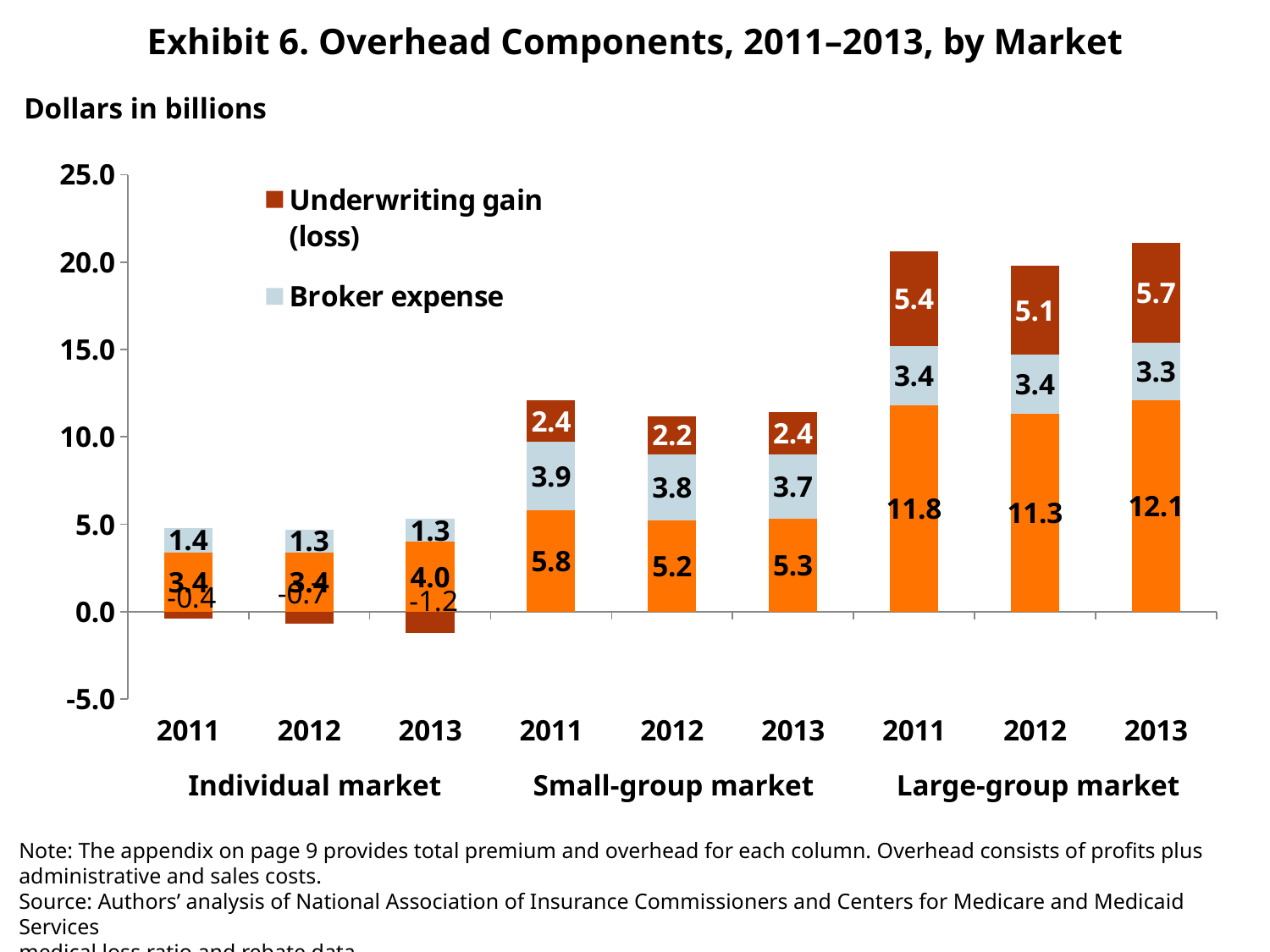
What kind of chart is shown on the slide? Stacked bar chart What is the Underwriting gain (loss) value for the Individual market in 2013? -1.2 What is the total of the stacked bar for the Large-group market in 2013? 21.1 Which is larger, the Underwriting gain (loss) for the Large-group market in 2011 or in 2012? 2011 Does the Underwriting gain (loss) for the Individual market rise or fall from 2011 to 2013? Fall How many stacked bars are plotted in the chart? 9 What is the difference between the Broker expense for the Small-group market in 2011 and in 2013? 0.2 What is the Broker expense value for the Small-group market in 2011? 3.9 Which market and year has the highest Underwriting gain (loss) value? Large-group market, 2013 How many series does the legend list? 2 Which market and year has the lowest Underwriting gain (loss) value? Individual market, 2013 What is the Underwriting gain (loss) value for the Large-group market in 2013? 5.7